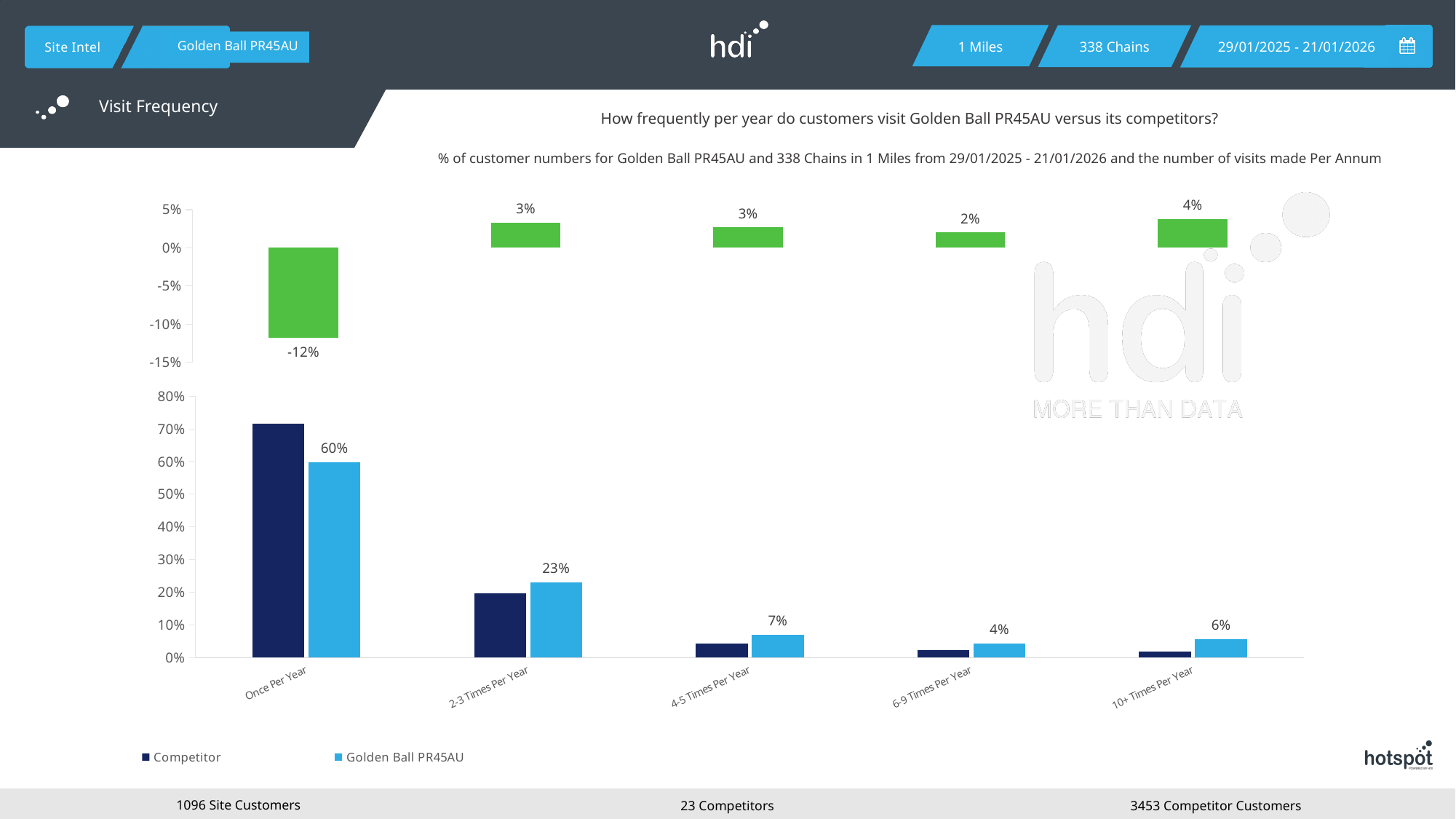
In the bottom chart, for Once Per Year, which is larger: Competitor or Golden Ball PR45AU? Competitor In the bottom chart, what is the value for Golden Ball PR45AU in the Once Per Year category? 60% In the top chart, what is the value shown for Once Per Year? -12% In the bottom chart, is the Competitor value for 2-3 Times Per Year greater or less than 30%? less In the top chart, which category has the highest value? 10+ Times Per Year In the bottom chart, is the Competitor value for Once Per Year greater or less than 60%? greater In the top chart, what is the value shown for 10+ Times Per Year? 4% How many series does the legend of the bottom chart list? 2 In the top chart, which category has the lowest value? Once Per Year How many categories are shown on the x axis of the bottom chart? 5 In the bottom chart, what is the difference between the Golden Ball PR45AU values for Once Per Year and 2-3 Times Per Year? 37 percentage points In the bottom chart, what is the value for Golden Ball PR45AU in the 2-3 Times Per Year category? 23%